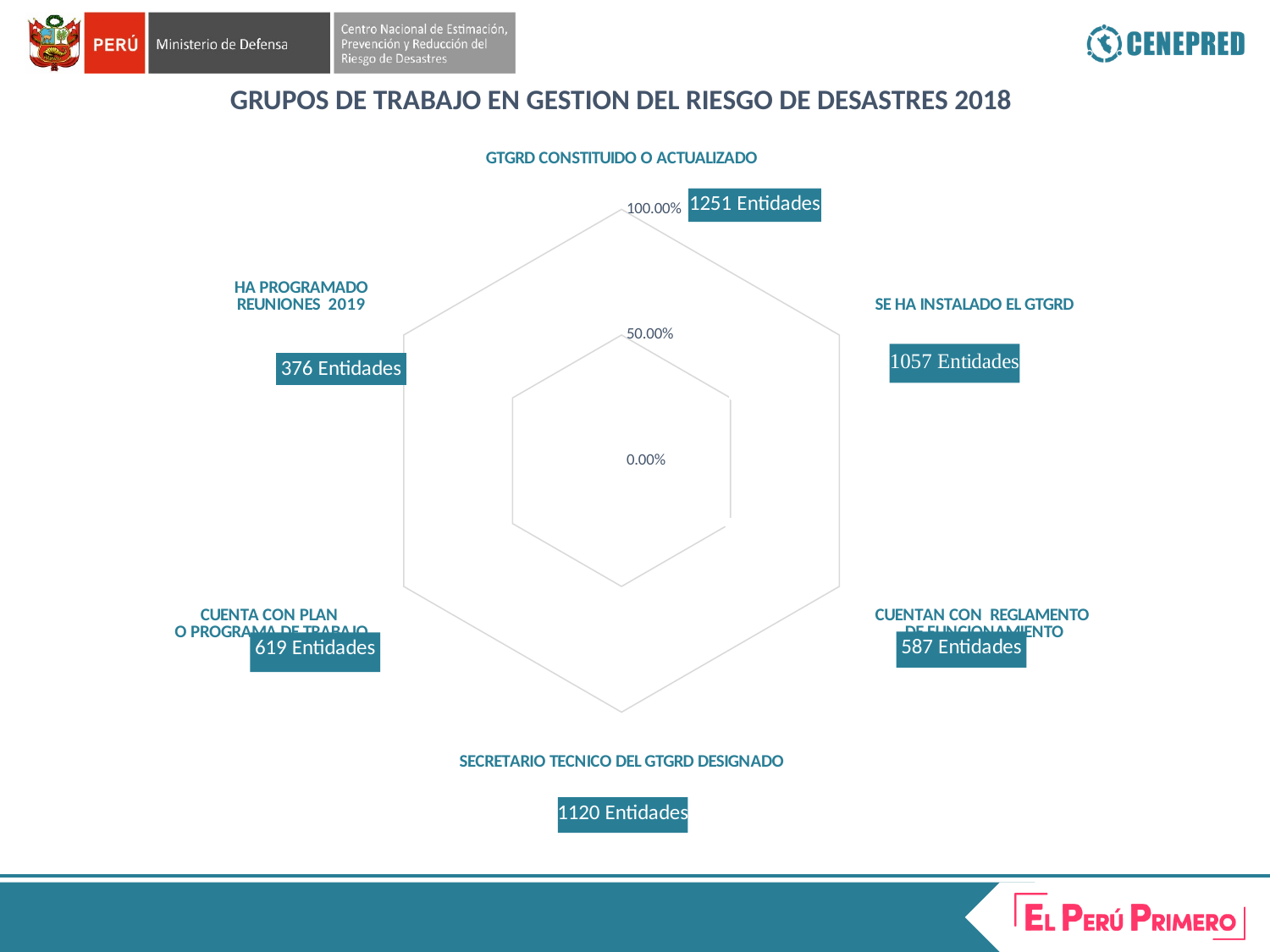
How many entities are shown for GTGRD CONSTITUIDO O ACTUALIZADO? 1251 Entidades What is the highest percentage tick shown on the radar chart's axis? 100.00% How many categories (axes) does the radar chart have? 6 What is the difference in entities between GTGRD CONSTITUIDO O ACTUALIZADO and SE HA INSTALADO EL GTGRD? 194 What is the title of the slide's chart? GRUPOS DE TRABAJO EN GESTION DEL RIESGO DE DESASTRES 2018 Which category has the lowest number of entities? HA PROGRAMADO REUNIONES 2019 How many entities are shown for SECRETARIO TECNICO DEL GTGRD DESIGNADO? 1120 Entidades How many entities are shown for HA PROGRAMADO REUNIONES 2019? 376 Entidades How many entities are shown for SE HA INSTALADO EL GTGRD? 1057 Entidades Which has more entities, SECRETARIO TECNICO DEL GTGRD DESIGNADO or SE HA INSTALADO EL GTGRD? SECRETARIO TECNICO DEL GTGRD DESIGNADO What kind of chart is shown on the slide? Radar chart Which category has the highest number of entities? GTGRD CONSTITUIDO O ACTUALIZADO